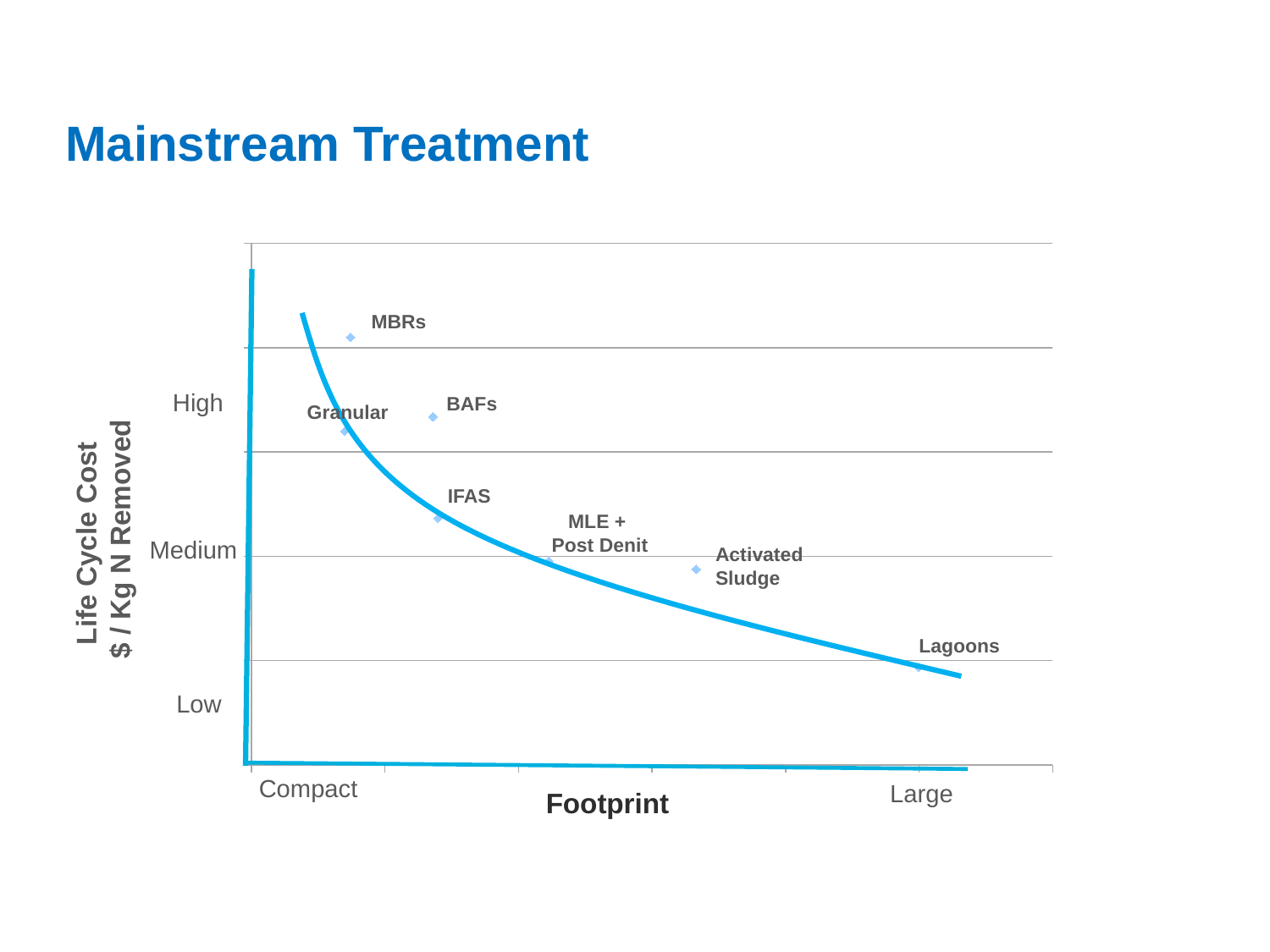
Which has a larger footprint, Activated Sludge or IFAS? Activated Sludge Which treatment technology has the largest footprint on the chart? Lagoons Which treatment technology has the highest life cycle cost on the chart? MBRs Which has a higher life cycle cost, MBRs or Lagoons? MBRs What kind of chart is shown on the slide? Scatter chart Which has a higher life cycle cost, BAFs or IFAS? BAFs Which treatment technology has the lowest life cycle cost on the chart? Lagoons How many treatment technologies are plotted as points on the chart? 7 What is the label of the x axis? Footprint As footprint increases from Compact to Large, does life cycle cost rise or fall along the curve? Fall What is the title of the slide containing the chart? Mainstream Treatment Is the life cycle cost for Lagoons above or below the Medium level on the y axis? below